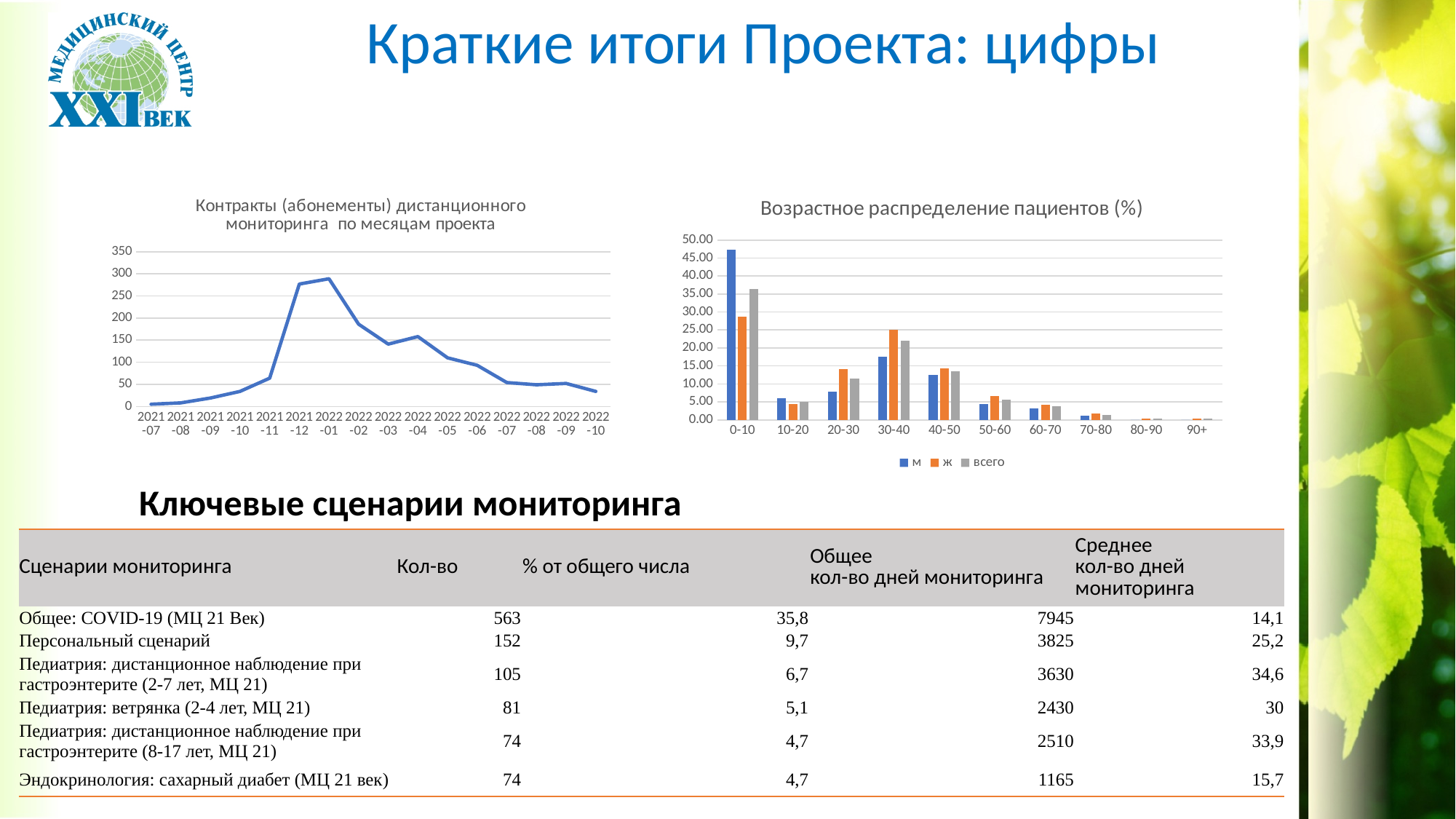
In the right chart (age distribution), how many age categories are shown on the x axis? 10 In the right chart (age distribution), which series has the highest bar in the 0-10 group? м In the left chart (contracts by month), how many months are plotted on the x axis? 16 In the left chart (contracts by month), is the value for 2021-07 greater or less than 50? less In the right chart (age distribution), for the 30-40 group, which is larger: "м" or "ж"? ж What kind of chart is the right chart titled "Возрастное распределение пациентов (%)"? bar chart In the left chart (contracts by month), is the value for 2022-01 greater or less than 250? greater In the left chart (contracts by month), do the values rise or fall from 2022-01 to 2022-10? fall In the left chart (contracts by month), which month has the highest value? 2022-01 What kind of chart is the left chart titled "Контракты (абонементы) дистанционного мониторинга по месяцам проекта"? line chart In the right chart (age distribution), is the value of the "м" series for the 0-10 group greater or less than 40.00? greater In the right chart (age distribution), how many series does the legend list? 3